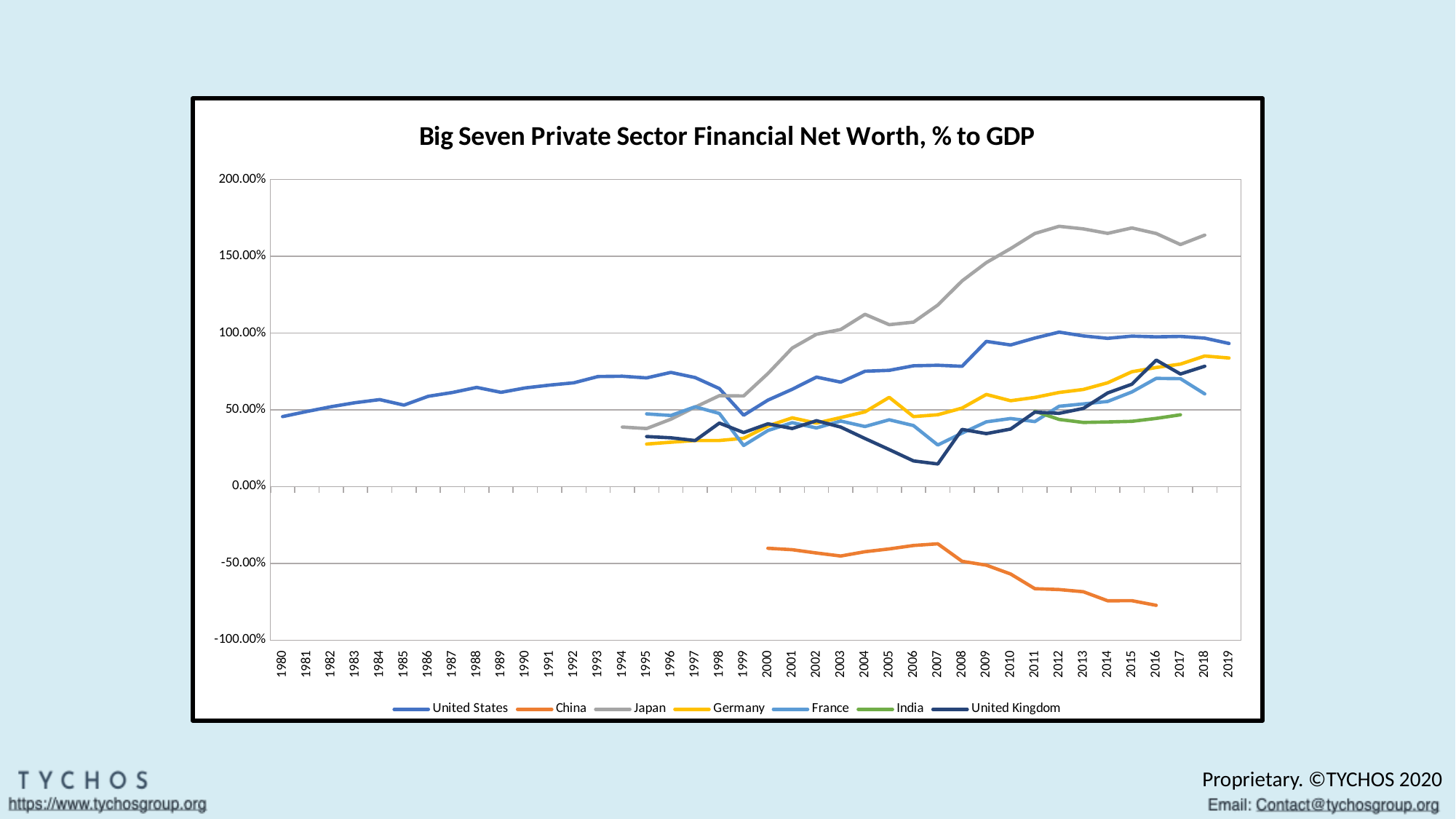
How many series does the legend list? 7 Which series has the lowest values on the chart? China Does the China line rise or fall from 2007 to 2016? Falls In 2018, which is higher, Germany or France? Germany Is the value for Japan in 2012 greater or less than 150.00%? greater Is the value for China in 2016 greater or less than -50.00%? less Which series reaches the highest value on the chart? Japan How many years are labelled on the x axis? 40 Is the value for United States in 1980 greater or less than 100.00%? less What is the title of the chart? Big Seven Private Sector Financial Net Worth, % to GDP Does the Japan line rise or fall from 2000 to 2012? Rises What kind of chart is shown on the slide? Line chart